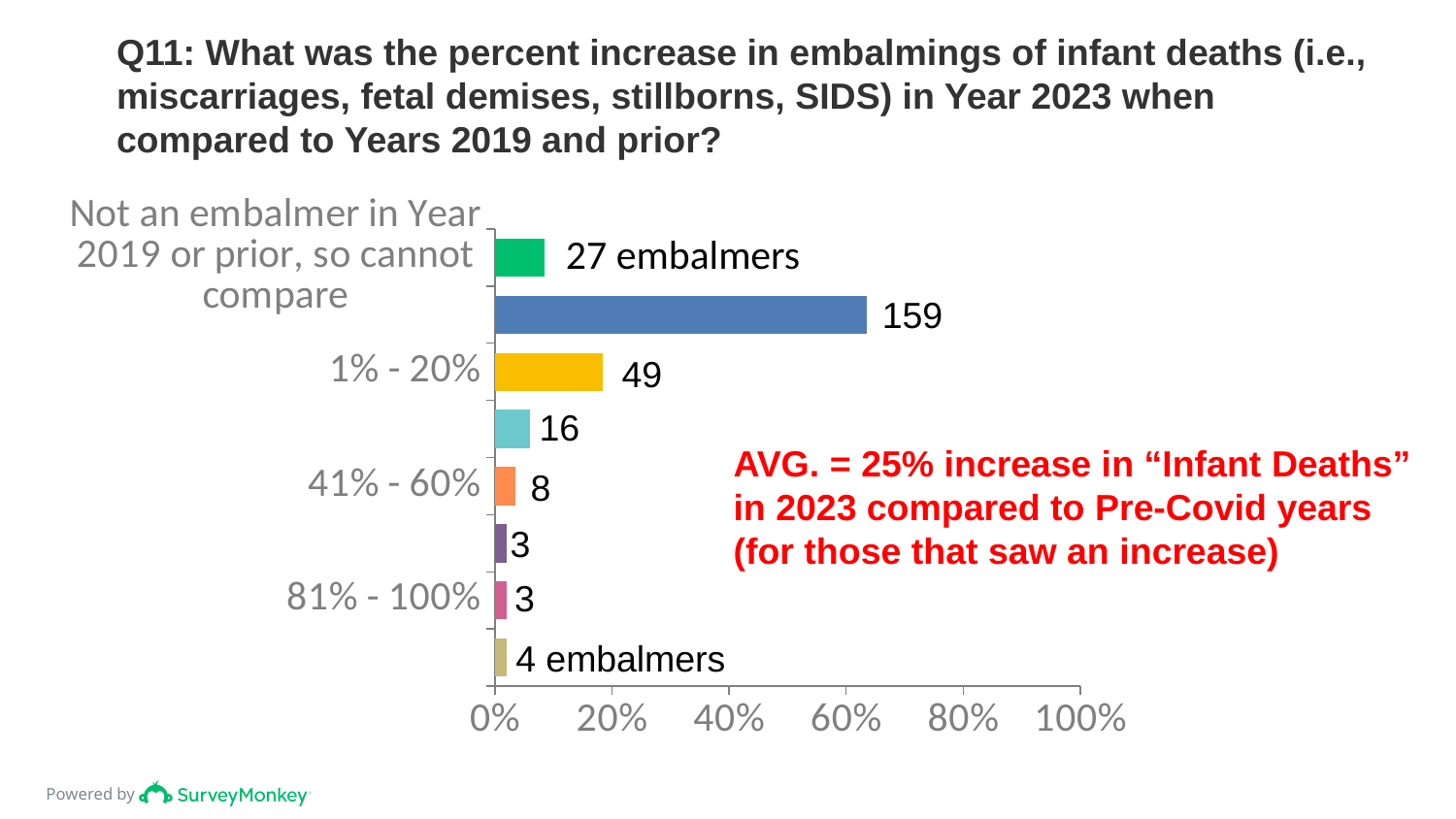
What is the highest tick value shown on the horizontal axis? 100% According to the red annotation on the chart, what is the average percent increase in "Infant Deaths" in 2023 compared to Pre-Covid years? 25% Which category has the larger value, "1% - 20%" or "41% - 60%"? 1% - 20% What is the value shown for the category "1% - 20%"? 49 How many bars are plotted in the chart? 8 Which category has the larger value, "41% - 60%" or "81% - 100%"? 41% - 60% What is the largest value labeled on any bar in the chart? 159 What type of chart is shown on the slide? bar chart What is the value shown for the category "41% - 60%"? 8 What is the value shown for the category "Not an embalmer in Year 2019 or prior, so cannot compare"? 27 embalmers What is the value shown for the category "81% - 100%"? 3 What is the difference between the values for "1% - 20%" and "41% - 60%"? 41